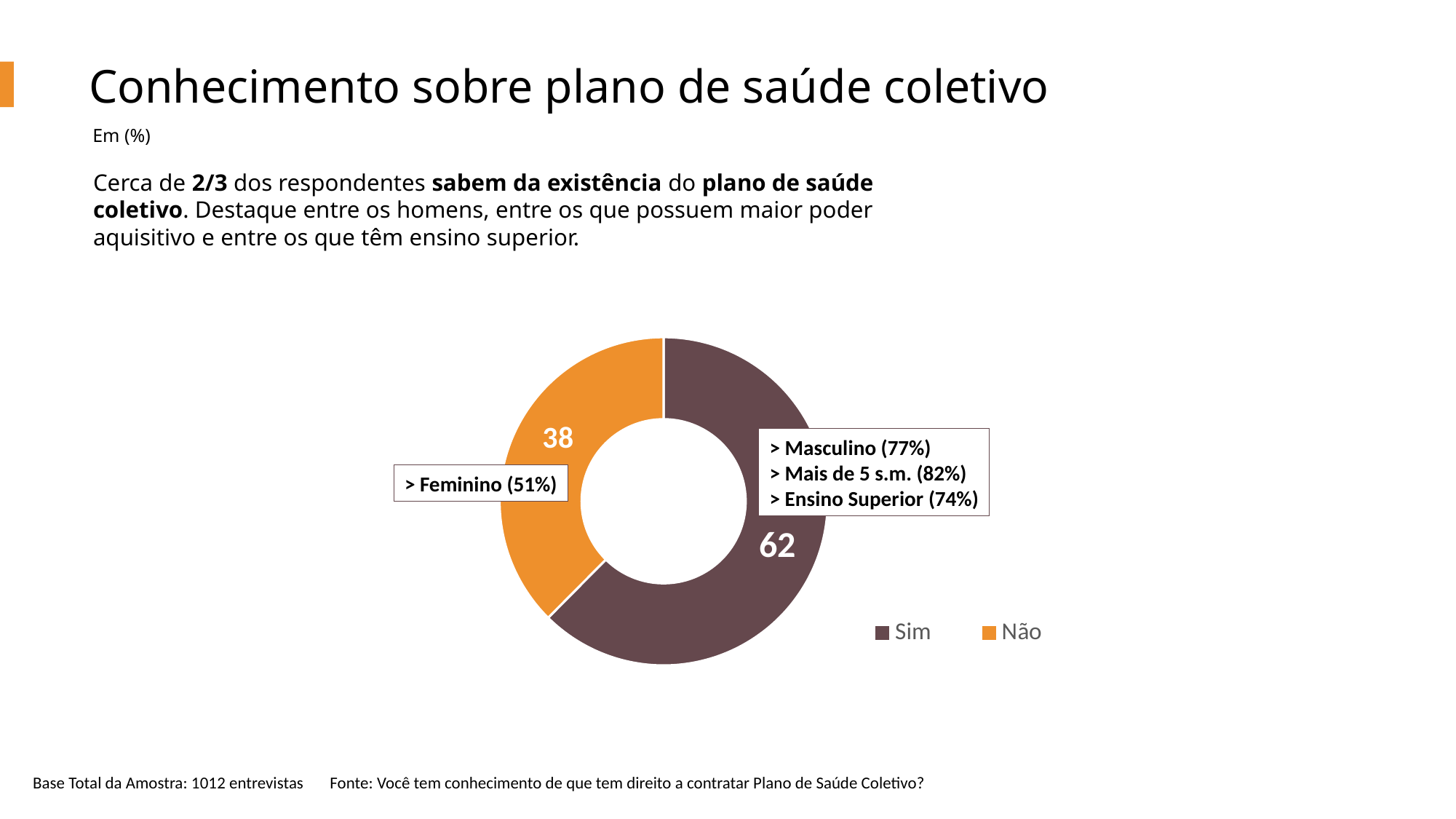
What value is shown for the "Não" slice of the doughnut chart? 38 What is the total of the two slice values shown on the chart? 100 What kind of chart is shown on the slide? Doughnut (pie) chart Which slice of the chart is the largest? Sim Which slice of the chart is the smallest? Não What is the title of the slide containing the chart? Conhecimento sobre plano de saúde coletivo Which colour represents "Não" in the chart? Orange How many slices does the chart have? 2 What is the difference between the "Sim" and "Não" values? 24 What value is shown for the "Sim" slice of the doughnut chart? 62 How many entries does the legend list? 2 Which is larger, the value for "Sim" or the value for "Não"? Sim